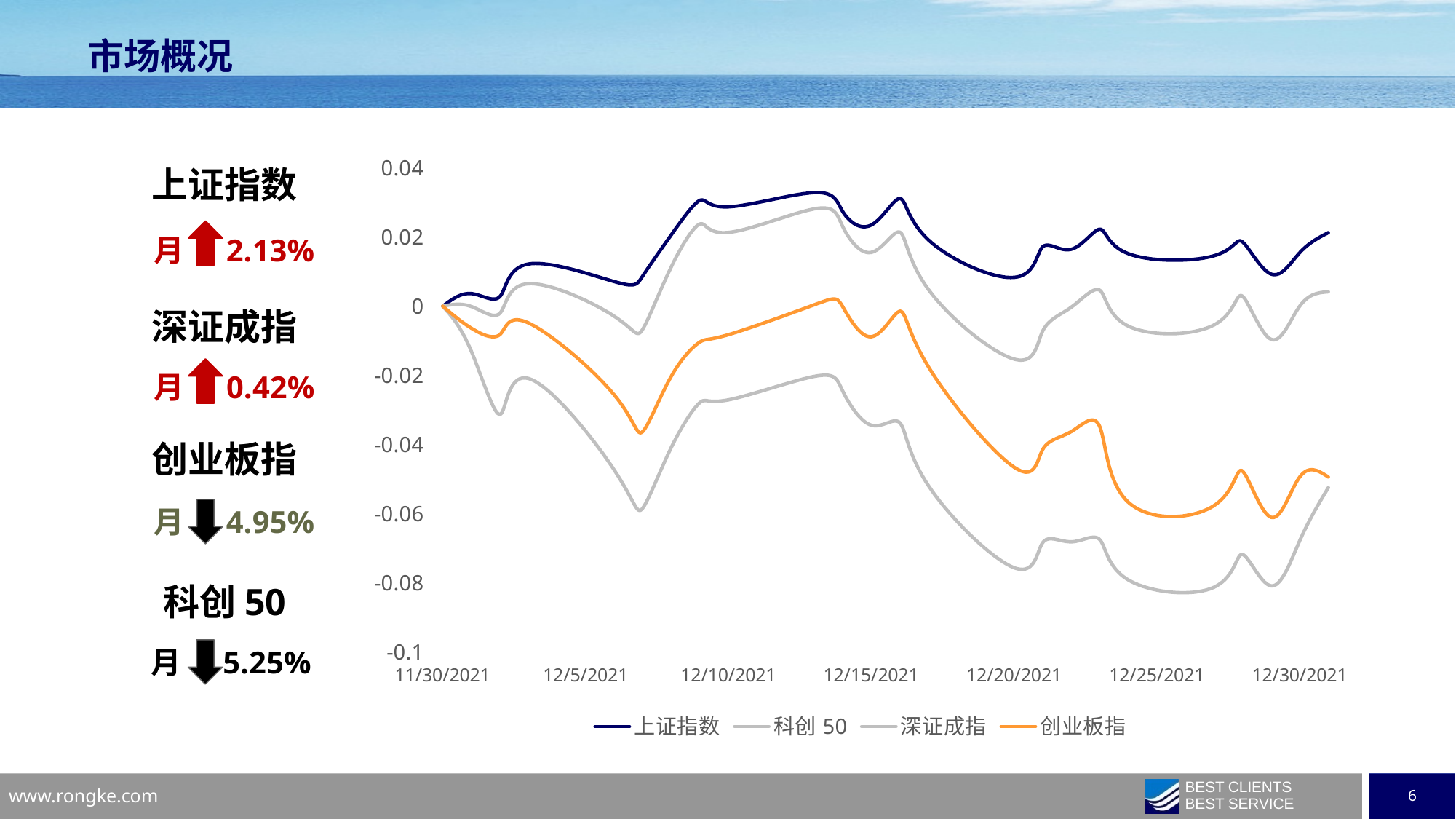
Which series has the highest value at 12/30/2021? 上证指数 Which series is drawn in orange in the chart? 创业板指 What kind of chart is shown on the slide? line chart Is the value of 创业板指 at 12/20/2021 greater or less than -0.02? less How many series does the chart legend list? 4 Is the value of 上证指数 at 12/10/2021 greater or less than 0.02? greater Is the value of 上证指数 at 12/30/2021 greater or less than 0? greater How many date labels are shown on the x axis of the chart? 7 At 12/30/2021, which is higher: 上证指数 or 创业板指? 上证指数 What is the first date label on the x axis of the chart? 11/30/2021 Does the 创业板指 line overall rise or fall from 11/30/2021 to 12/30/2021? fall